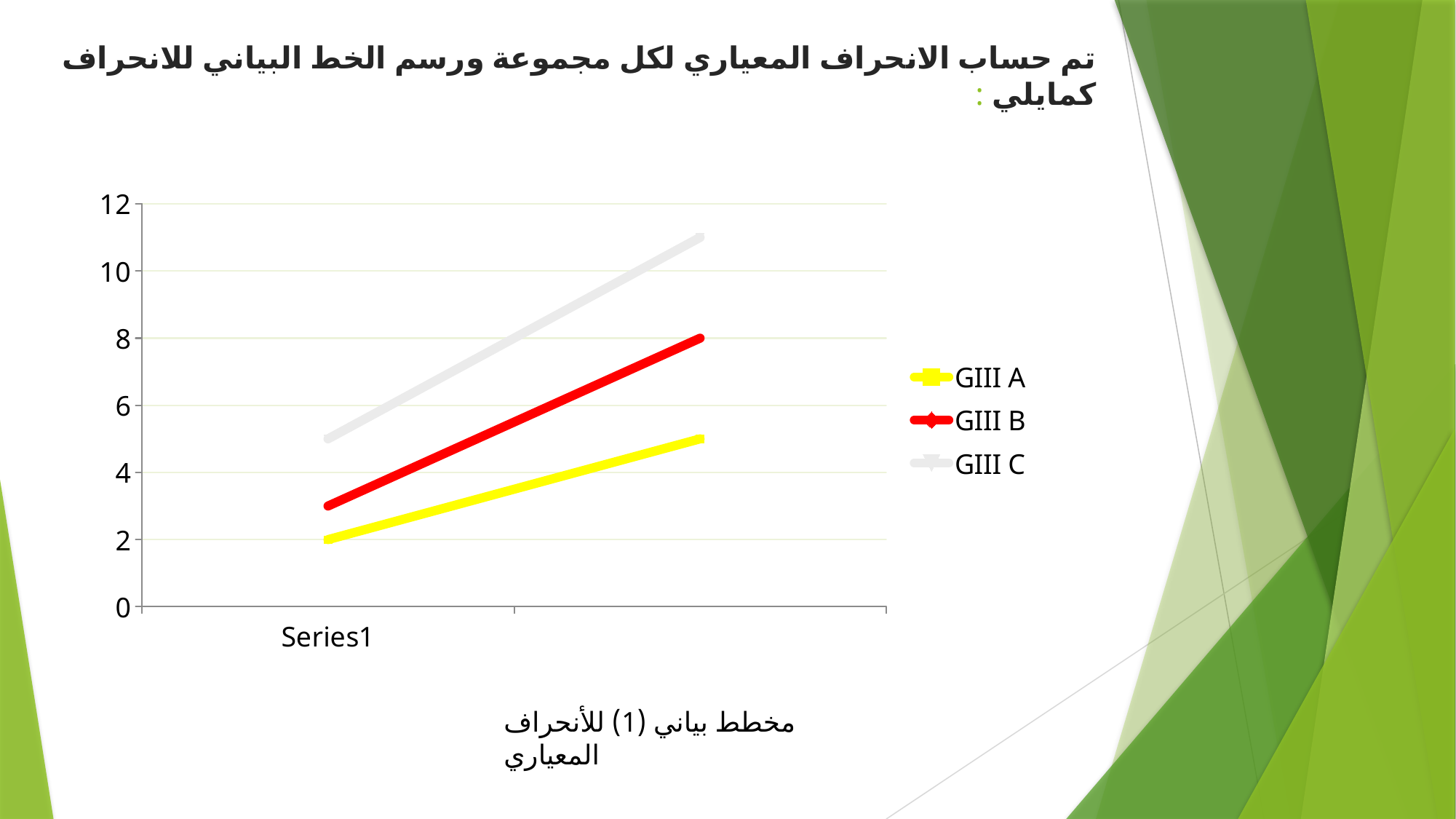
Which series has the lowest value at Series1? GIII A How many series does the legend list? 3 Is the value for GIII C at Series1 greater or less than 4? greater What is the value for GIII A at Series1? 2 Does the GIII A line rise or fall from left to right? rises What kind of chart is shown on the slide? line chart Does the GIII C line rise or fall from left to right? rises At Series1, which is larger, GIII B or GIII A? GIII B What are the series names listed in the legend? GIII A, GIII B, GIII C What colour is the GIII B line? red Is the value for GIII B at Series1 greater or less than 4? less Which series has the highest value at Series1? GIII C